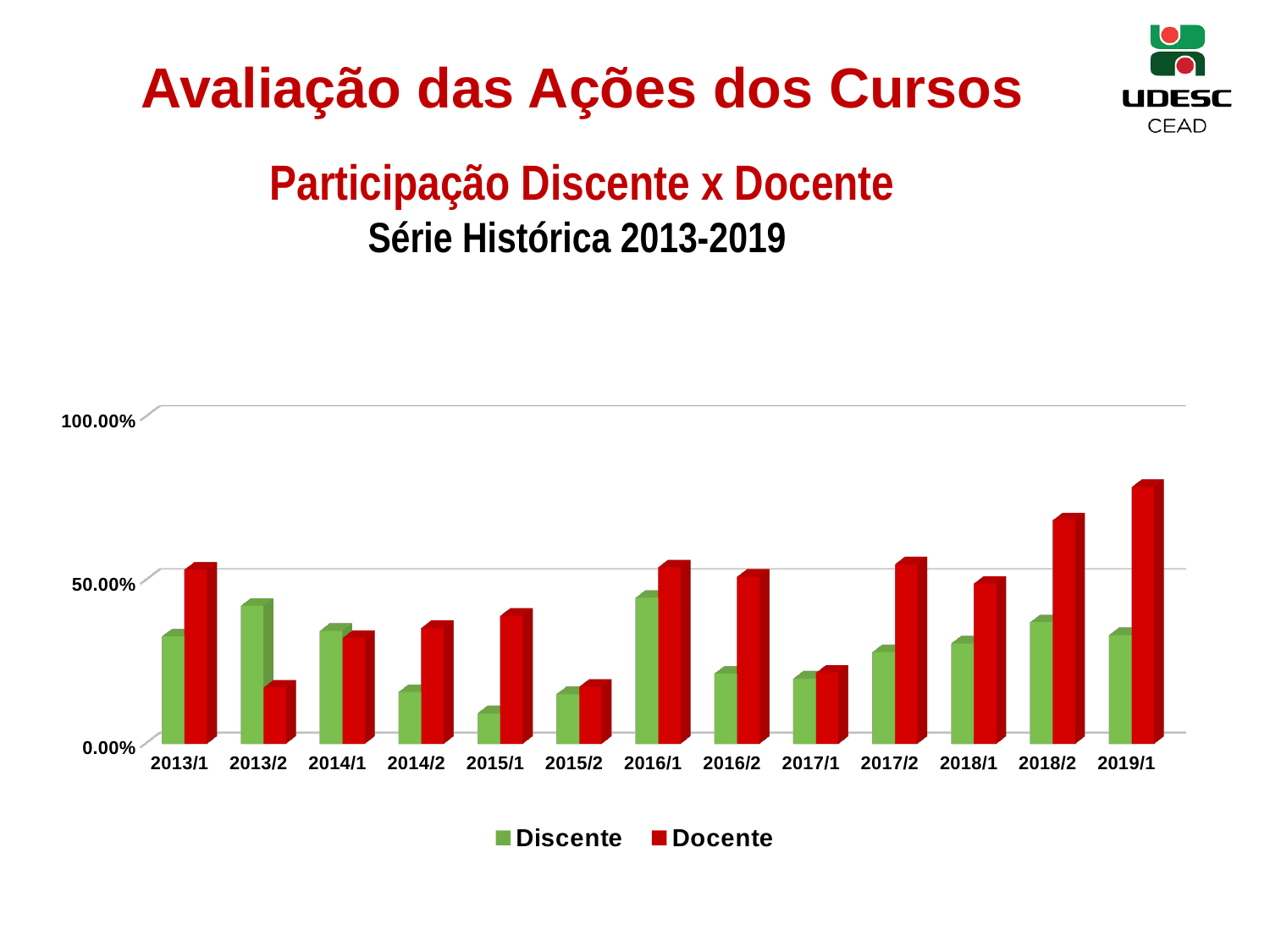
Do the Docente values rise or fall from 2017/1 to 2019/1? rise Which semester has the lowest Discente value? 2015/1 Which colour represents the Docente series in the legend? red Which semester has the highest Docente value? 2019/1 Is the Docente value for 2019/1 greater or less than 50.00%? greater In 2013/2, which is larger, the Discente value or the Docente value? Discente Is the Docente value for 2018/2 greater or less than 50.00%? greater How many semesters (categories) are shown on the x axis? 13 In 2019/1, which is larger, the Discente value or the Docente value? Docente How many series does the legend list? 2 What kind of chart is shown on the slide? bar chart Is the Discente value for 2013/2 greater or less than 50.00%? less